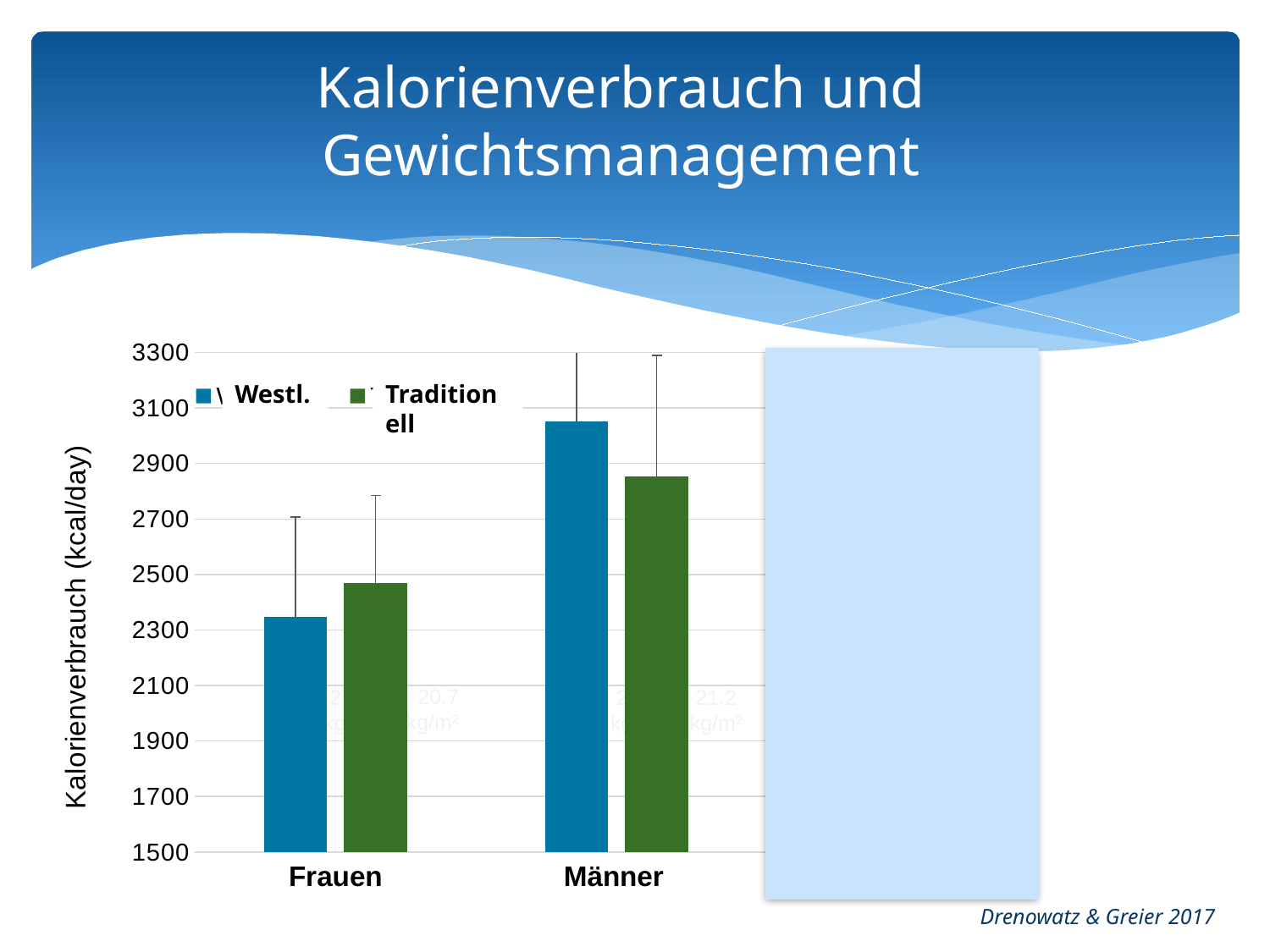
Which category and series has the highest bar in the chart? Männer, Westl. For Männer, which series has the larger value, Westl. or Traditionell? Westl. For Frauen, which series has the larger value, Westl. or Traditionell? Traditionell Is the Westl. value for Männer greater or less than 2900? greater Is the Westl. value for Frauen greater or less than 2500? less How many categories are shown on the x axis of the chart? 2 What kind of chart is shown on the slide? bar chart Which colour represents the Traditionell series in the chart? green Is the Traditionell value for Männer greater or less than 2700? greater What is the label of the chart's vertical axis? Kalorienverbrauch (kcal/day) How many series does the chart's legend list? 2 Which category and series has the lowest bar in the chart? Frauen, Westl.